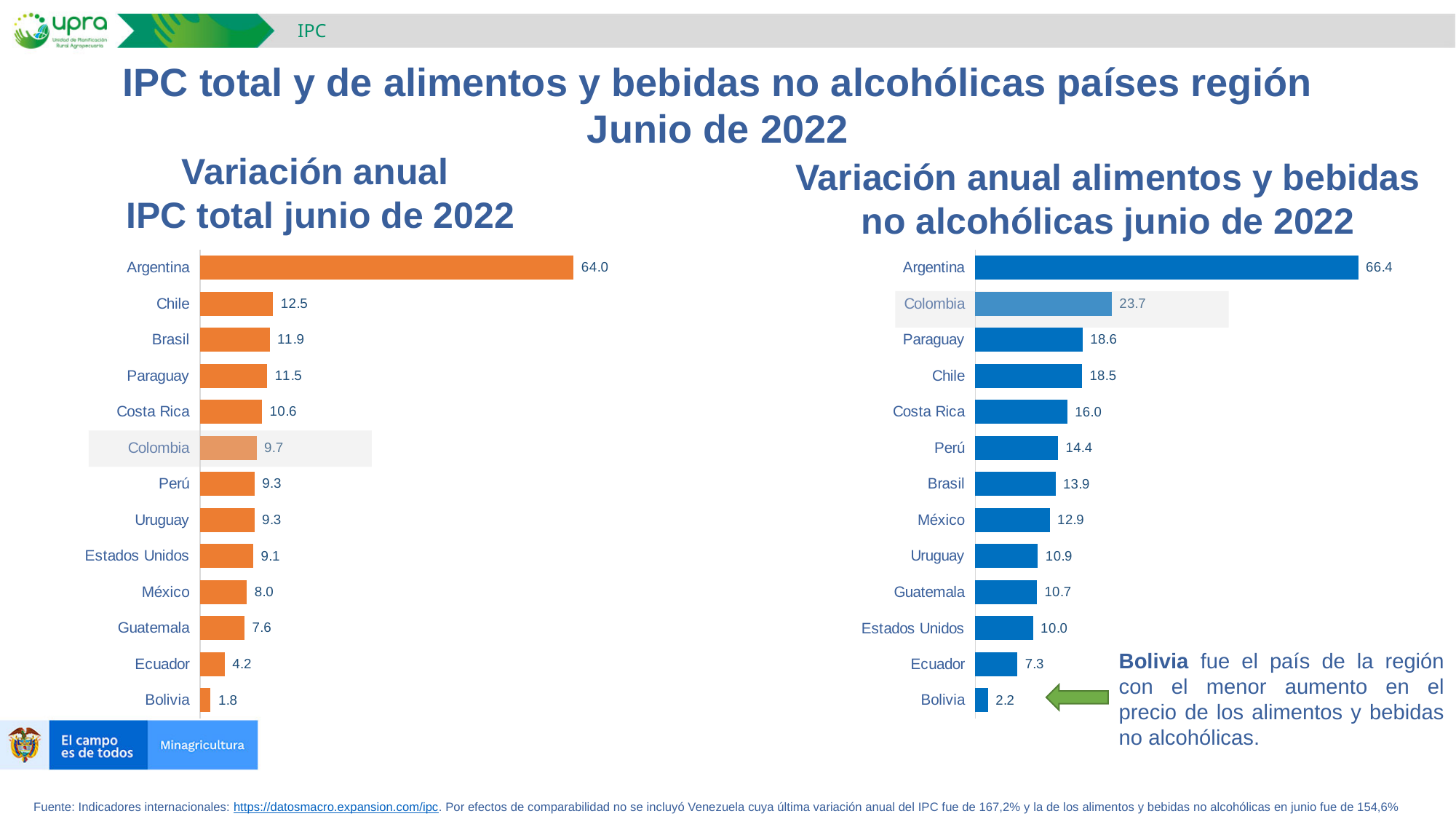
In the 'Variación anual IPC total junio de 2022' chart, what is the value for Colombia? 9.7 In the 'Variación anual IPC total junio de 2022' chart, which is larger, the value for Costa Rica or the value for México? Costa Rica In the 'Variación anual alimentos y bebidas no alcohólicas junio de 2022' chart, which country has the lowest value? Bolivia What colour are the bars in the 'Variación anual IPC total junio de 2022' chart? Orange In the 'Variación anual alimentos y bebidas no alcohólicas junio de 2022' chart, what is the difference between the values for Argentina and Colombia? 42.7 How many countries are shown in the 'Variación anual IPC total junio de 2022' chart? 13 In the 'Variación anual IPC total junio de 2022' chart, what is the value for Estados Unidos? 9.1 In the 'Variación anual alimentos y bebidas no alcohólicas junio de 2022' chart, which is larger, the value for Perú or the value for Brasil? Perú What kind of chart is the 'Variación anual alimentos y bebidas no alcohólicas junio de 2022' chart? Bar chart In the 'Variación anual IPC total junio de 2022' chart, which country has the highest value? Argentina In the 'Variación anual IPC total junio de 2022' chart, what is the difference between the values for Chile and Brasil? 0.6 In the 'Variación anual alimentos y bebidas no alcohólicas junio de 2022' chart, what is the value for Paraguay? 18.6